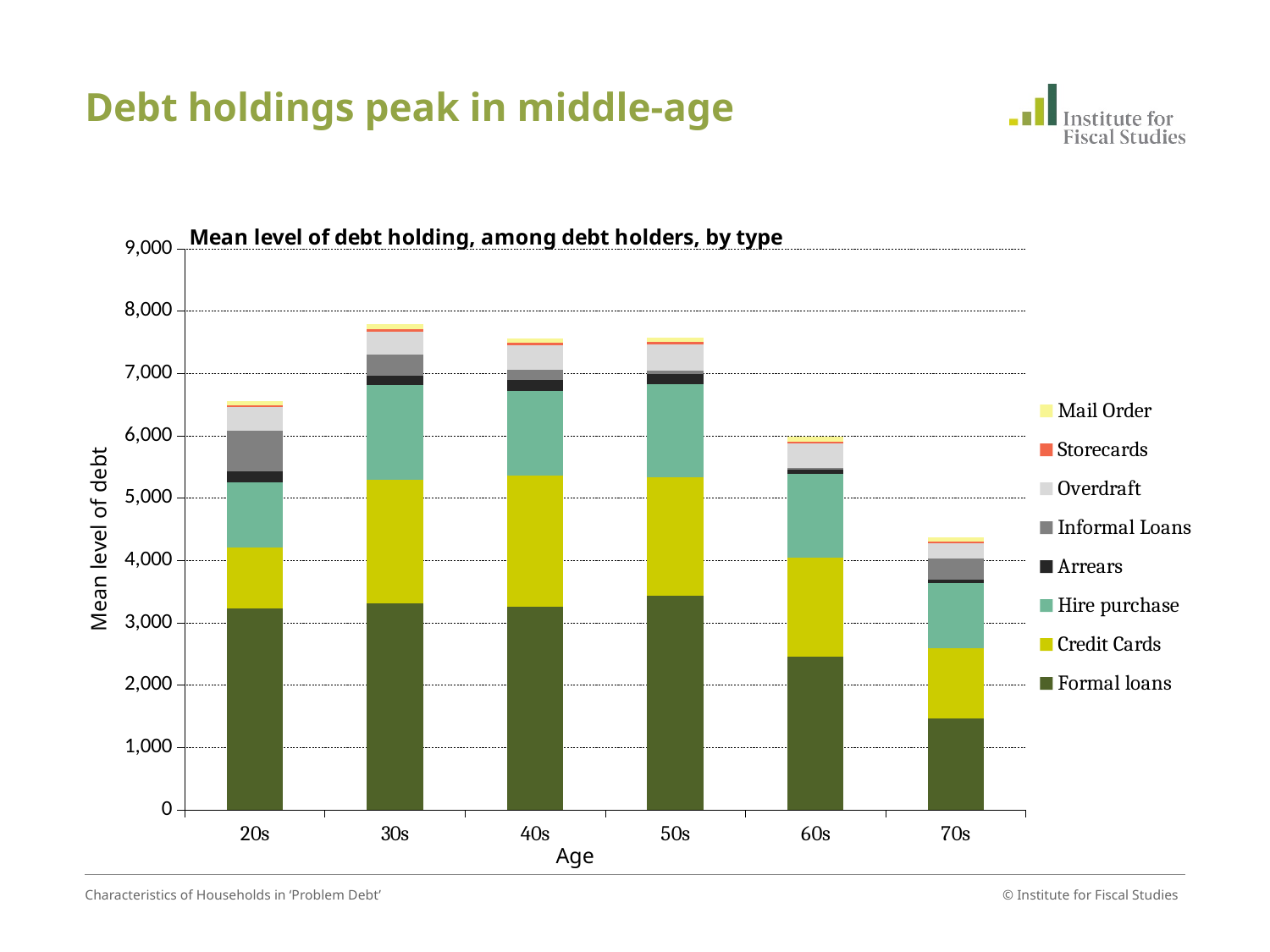
Is the Formal loans value for the 70s age group greater or less than 2,000? less How many debt types does the legend of the chart list? 8 What is the title of the chart? Mean level of debt holding, among debt holders, by type What kind of chart is shown on the slide? Stacked bar chart Does the total mean level of debt rise or fall from the 30s age group to the 70s age group? fall Which age group has the lowest total mean level of debt? 70s How many age groups are shown on the x axis of the chart? 6 Is the total mean level of debt for the 20s age group greater or less than 6,000? greater Is the total mean level of debt for the 70s age group greater or less than 5,000? less Which age group has the highest total mean level of debt? 30s Which has a larger total mean level of debt, the 20s or the 60s age group? 20s Which debt type is shown at the bottom of each stacked bar? Formal loans